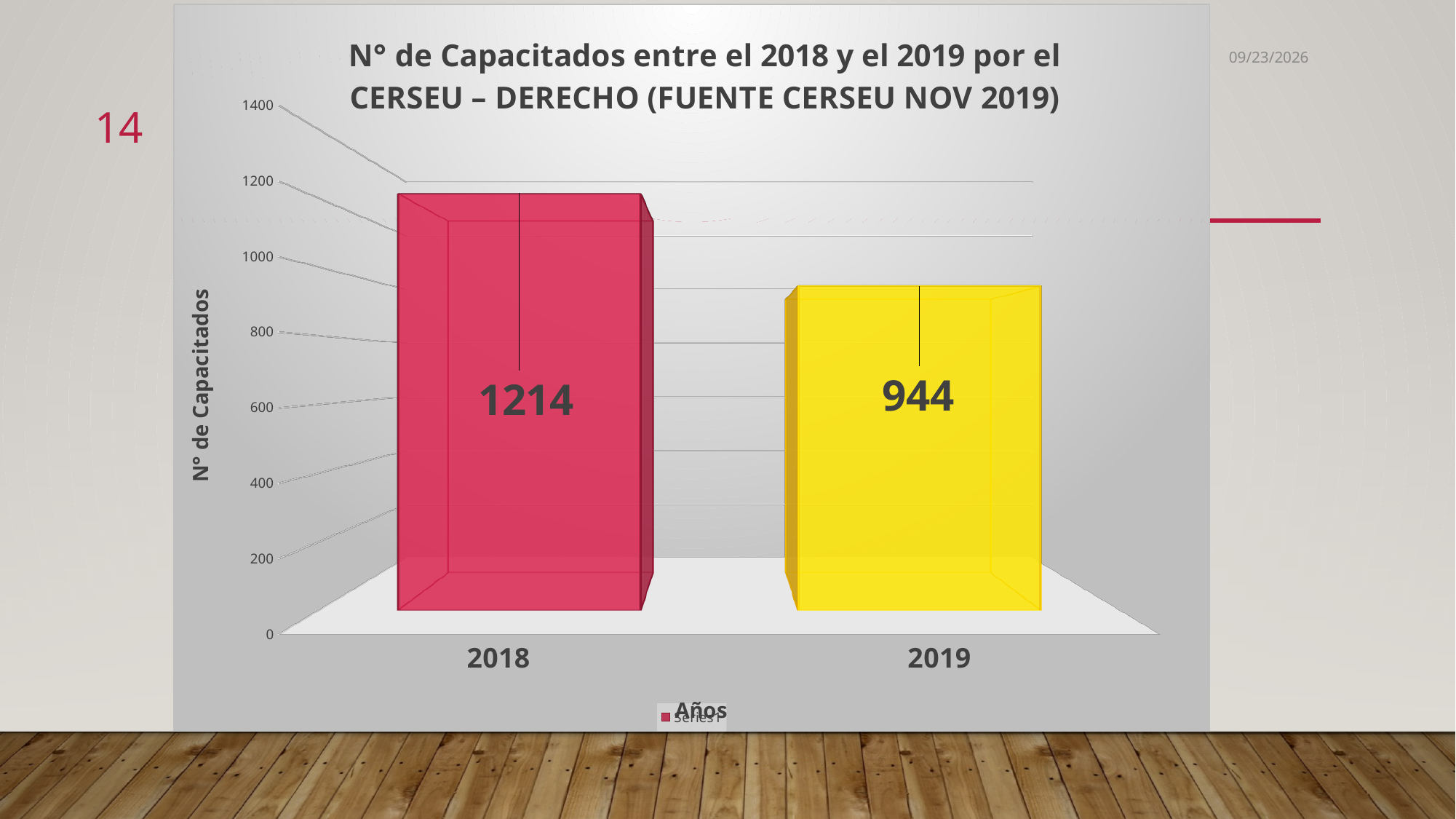
What is the difference between the 2018 and 2019 values? 270 What is the number of capacitados for 2018? 1214 Is the value for 2019 greater or less than 1000? less Is the value for 2018 larger or smaller than the value for 2019? larger Which year has the lower number of capacitados? 2019 Do the values rise or fall from 2018 to 2019? fall What is the number of capacitados for 2019? 944 Is the value for 2018 greater or less than 1200? greater How many years are shown on the x axis? 2 What is the label of the vertical axis? N° de Capacitados What kind of chart is shown on the slide? bar chart Which year has the higher number of capacitados? 2018